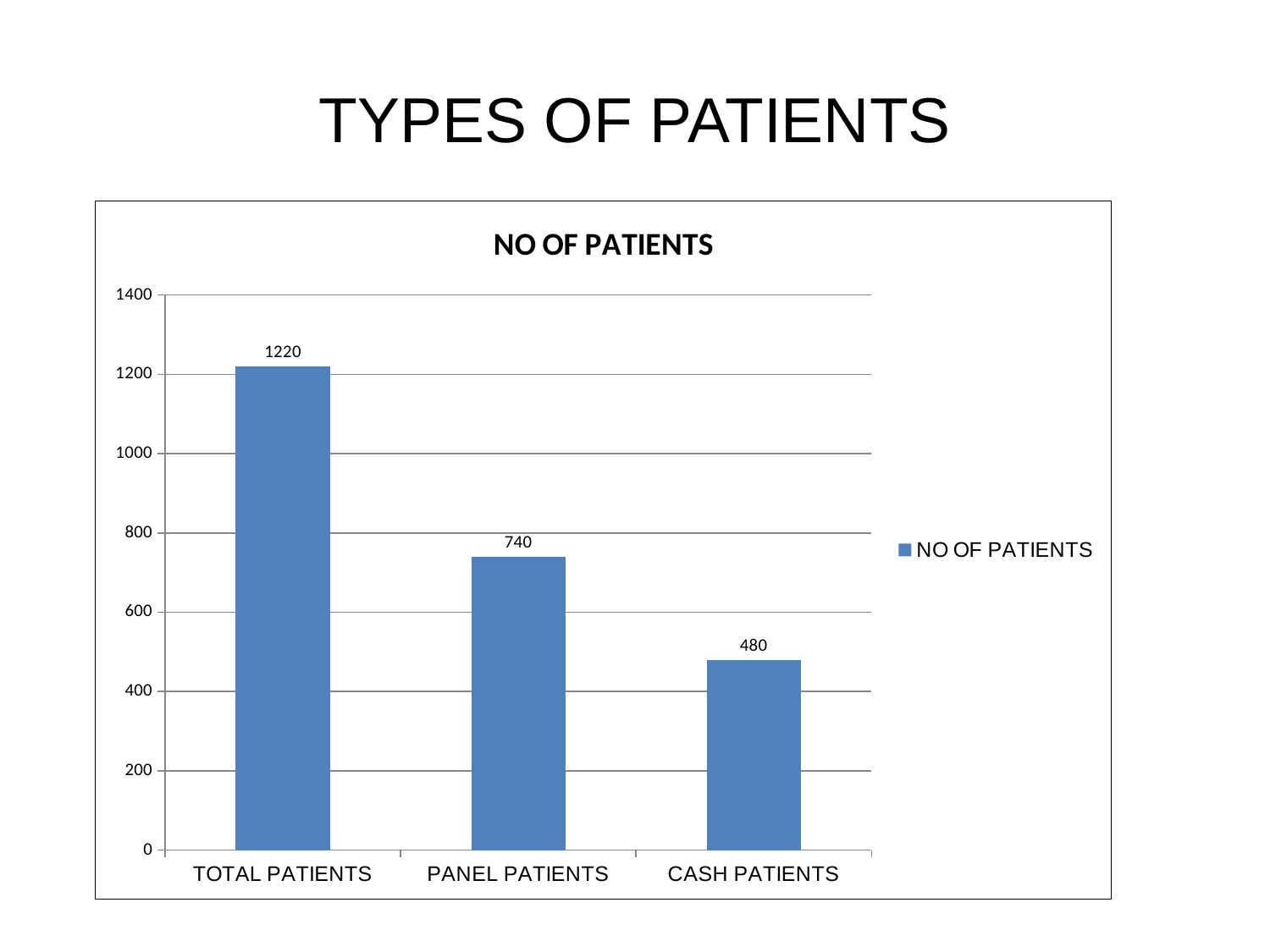
What is the difference between the values for TOTAL PATIENTS and PANEL PATIENTS? 480 Which is larger, the value for PANEL PATIENTS or the value for CASH PATIENTS? PANEL PATIENTS What is the value for PANEL PATIENTS? 740 How many categories are shown on the x axis? 3 What is the title of the chart? NO OF PATIENTS Is the value for PANEL PATIENTS greater or less than 600? greater Which category has the lowest value? CASH PATIENTS Which category has the highest value? TOTAL PATIENTS What is the difference between the values for PANEL PATIENTS and CASH PATIENTS? 260 What is the value for TOTAL PATIENTS? 1220 What is the value for CASH PATIENTS? 480 What kind of chart is shown on the slide? bar chart